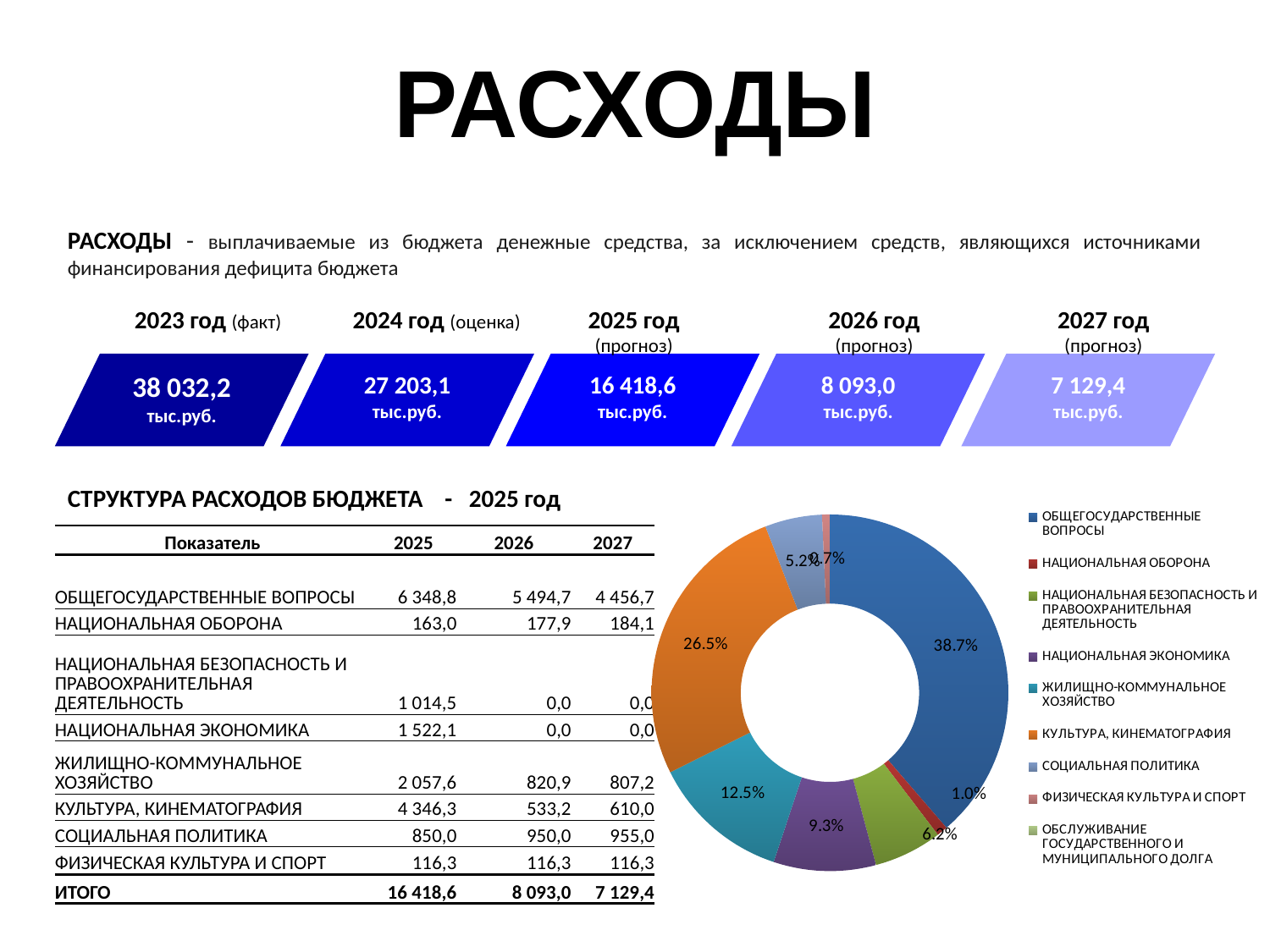
By how many percentage points does the ОБЩЕГОСУДАРСТВЕННЫЕ ВОПРОСЫ slice exceed the КУЛЬТУРА, КИНЕМАТОГРАФИЯ slice? 12.2 percentage points What percentage is shown for НАЦИОНАЛЬНАЯ ЭКОНОМИКА in the doughnut chart? 9.3% What share of the 2025 budget expenses does ОБЩЕГОСУДАРСТВЕННЫЕ ВОПРОСЫ take in the doughnut chart? 38.7% Which category has the largest slice in the doughnut chart? ОБЩЕГОСУДАРСТВЕННЫЕ ВОПРОСЫ Which labelled slice in the doughnut chart is the smallest? ФИЗИЧЕСКАЯ КУЛЬТУРА И СПОРТ (0.7%) What kind of chart is used to show the structure of budget expenses for 2025? Doughnut (pie) chart How many categories does the legend of the doughnut chart list? 9 How many percentage labels are shown on the doughnut chart? 8 Which slice is larger in the doughnut chart: СОЦИАЛЬНАЯ ПОЛИТИКА or НАЦИОНАЛЬНАЯ БЕЗОПАСНОСТЬ И ПРАВООХРАНИТЕЛЬНАЯ ДЕЯТЕЛЬНОСТЬ? НАЦИОНАЛЬНАЯ БЕЗОПАСНОСТЬ И ПРАВООХРАНИТЕЛЬНАЯ ДЕЯТЕЛЬНОСТЬ What colour is the largest slice of the doughnut chart? Blue What percentage is shown for ЖИЛИЩНО-КОММУНАЛЬНОЕ ХОЗЯЙСТВО in the doughnut chart? 12.5% What share does КУЛЬТУРА, КИНЕМАТОГРАФИЯ have in the doughnut chart? 26.5%